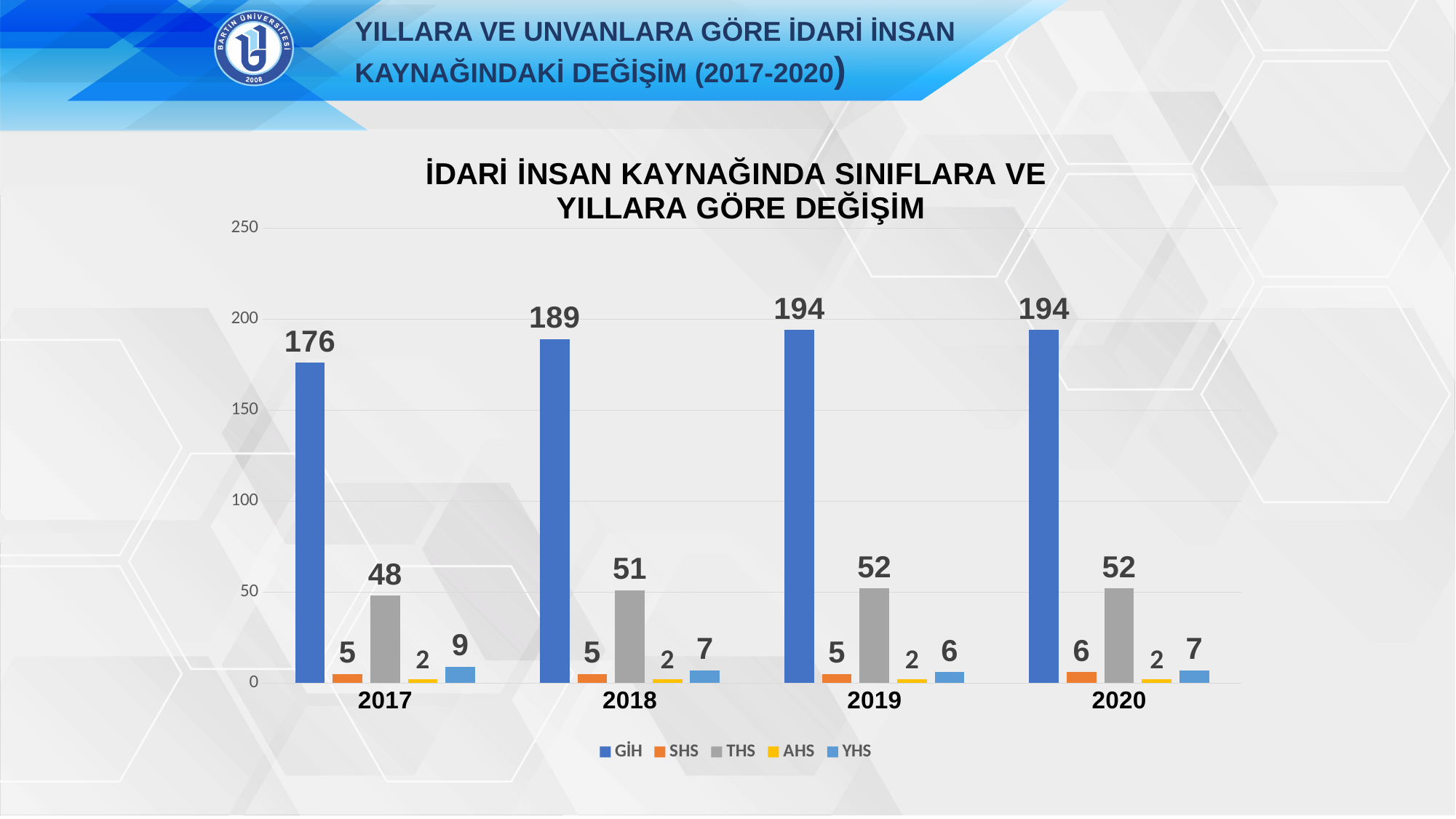
What is the value for THS in 2019? 52 What is the difference between the GİH values for 2018 and 2017? 13 Which is larger, the YHS value in 2017 or the YHS value in 2019? 2017 How many series does the legend list? 5 Is the value for GİH in 2019 greater or less than 150? greater In which year is the GİH value lowest? 2017 What is the value for GİH in 2017? 176 What is the value for SHS in 2020? 6 How many years are shown on the x axis? 4 What kind of chart is shown on the slide? bar chart Which series has the highest value in 2018? GİH What is the value for YHS in 2017? 9